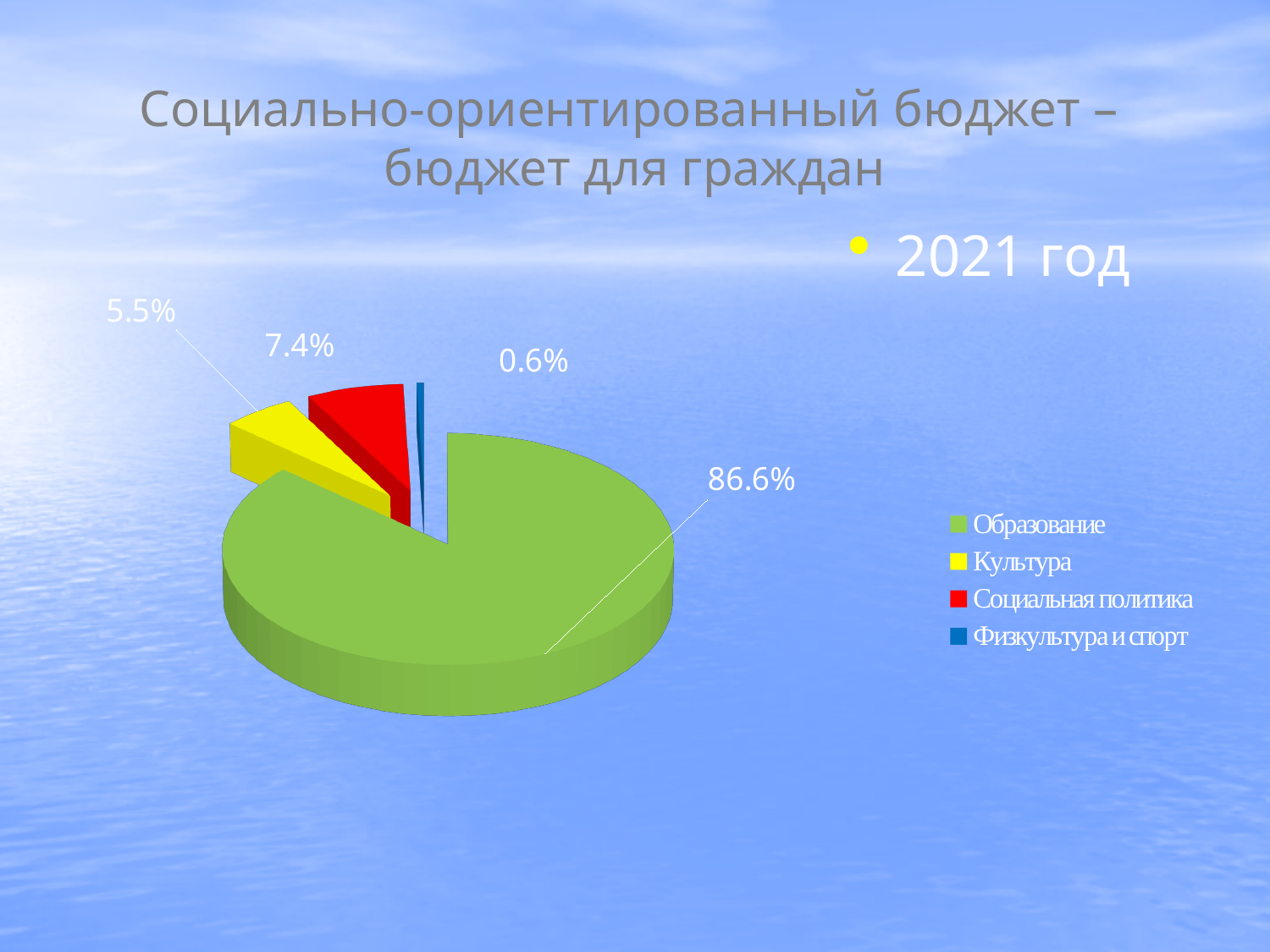
Which is larger, the slice for Культура or the slice for Социальная политика? Социальная политика What is the difference between the shares for Социальная политика and Культура? 1.9% What kind of chart is shown on the slide? pie chart What share of the pie does Культура have? 5.5% Which year does the slide say the chart refers to? 2021 год What share of the pie does Образование have? 86.6% What share of the pie does Физкультура и спорт have? 0.6% Which category has the smallest slice of the pie? Физкультура и спорт How many categories does the pie chart show? 4 Which category has the largest slice of the pie? Образование What colour is the slice for Культура? yellow